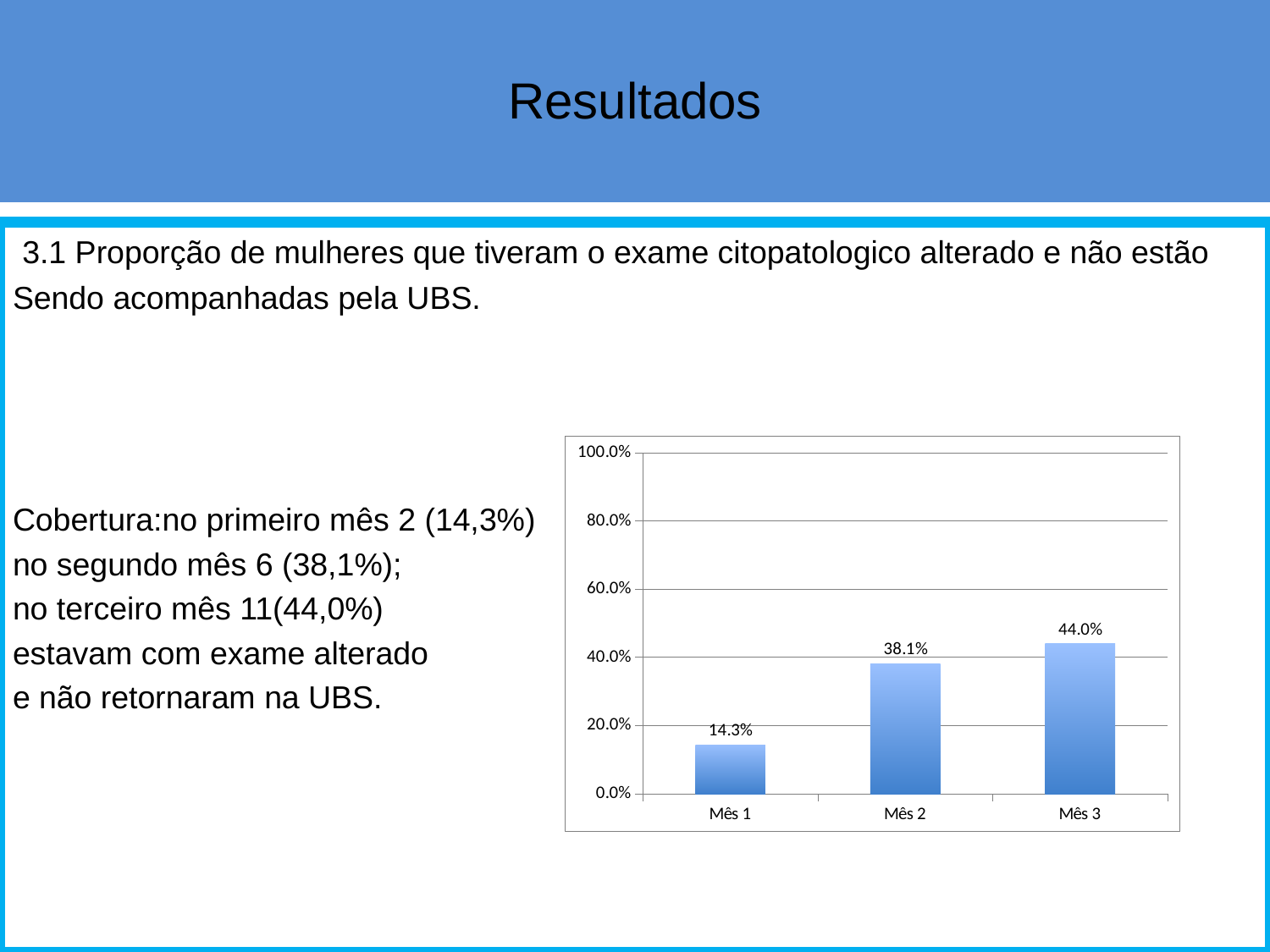
Which month has the highest value? Mês 3 What is the difference between the values for Mês 2 and Mês 1? 23.8% What is the difference between the values for Mês 3 and Mês 1? 29.7% What is the value for Mês 2? 38.1% Do the values rise or fall from Mês 1 to Mês 3? rise What is the value for Mês 1? 14.3% What is the value for Mês 3? 44.0% Which month has the lowest value? Mês 1 How many categories are shown on the x axis? 3 Which is larger, the value for Mês 2 or Mês 3? Mês 3 Is the value for Mês 2 greater or less than 20.0%? greater What kind of chart is shown on the slide? bar chart